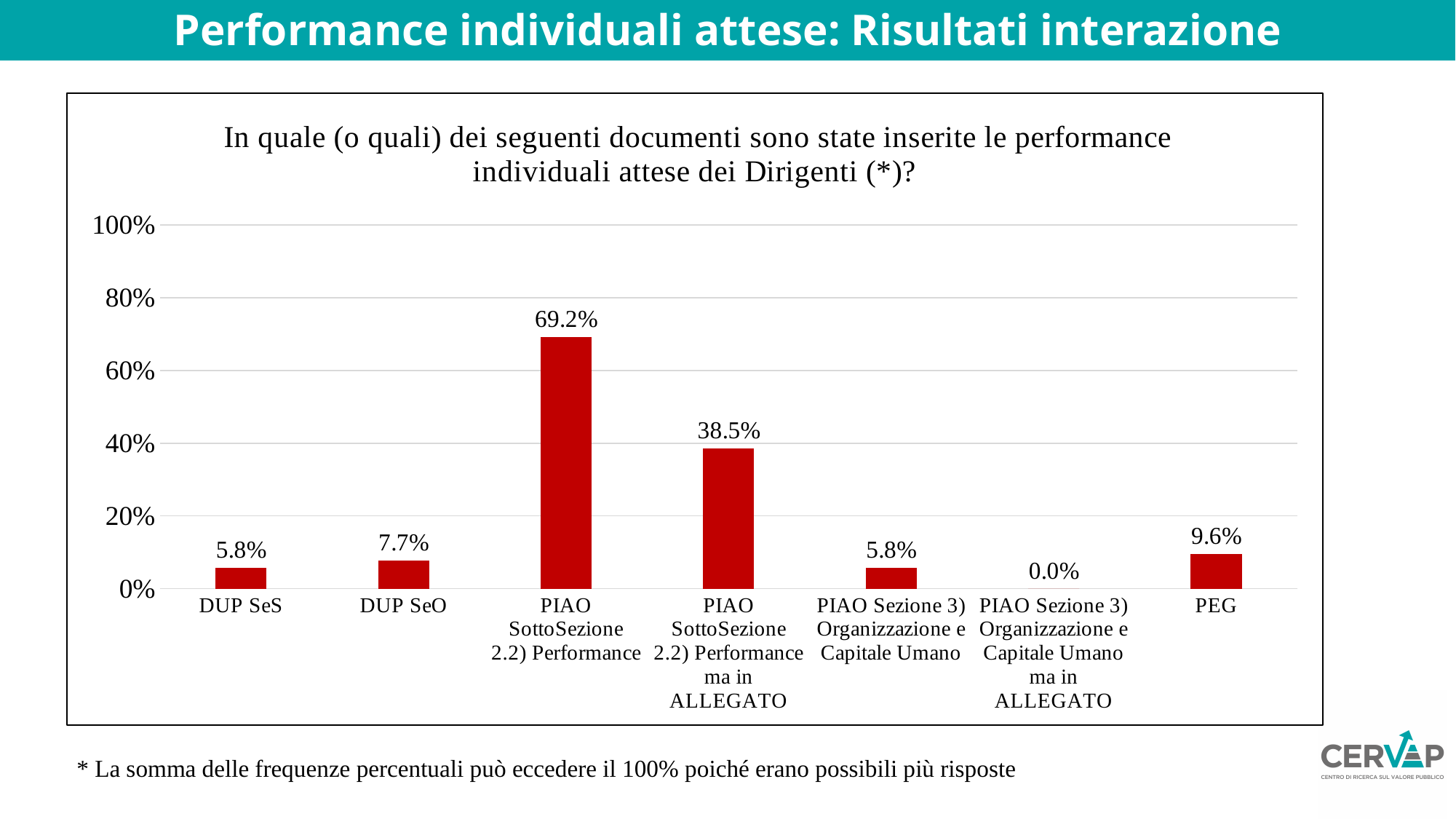
What is the value for PEG? 9.6% What is the value for PIAO SottoSezione 2.2) Performance? 69.2% Which is larger, the value for PEG or the value for DUP SeO? PEG How many categories are shown on the x axis? 7 Which category has the highest value? PIAO SottoSezione 2.2) Performance What kind of chart is shown on the slide? bar chart What is the value for PIAO SottoSezione 2.2) Performance ma in ALLEGATO? 38.5% What is the difference between the values for PIAO SottoSezione 2.2) Performance and PIAO SottoSezione 2.2) Performance ma in ALLEGATO? 30.7% What colour are the bars in the chart? red Is the value for PIAO SottoSezione 2.2) Performance greater or less than 60%? greater What is the value for DUP SeO? 7.7% Which category has the lowest value? PIAO Sezione 3) Organizzazione e Capitale Umano ma in ALLEGATO